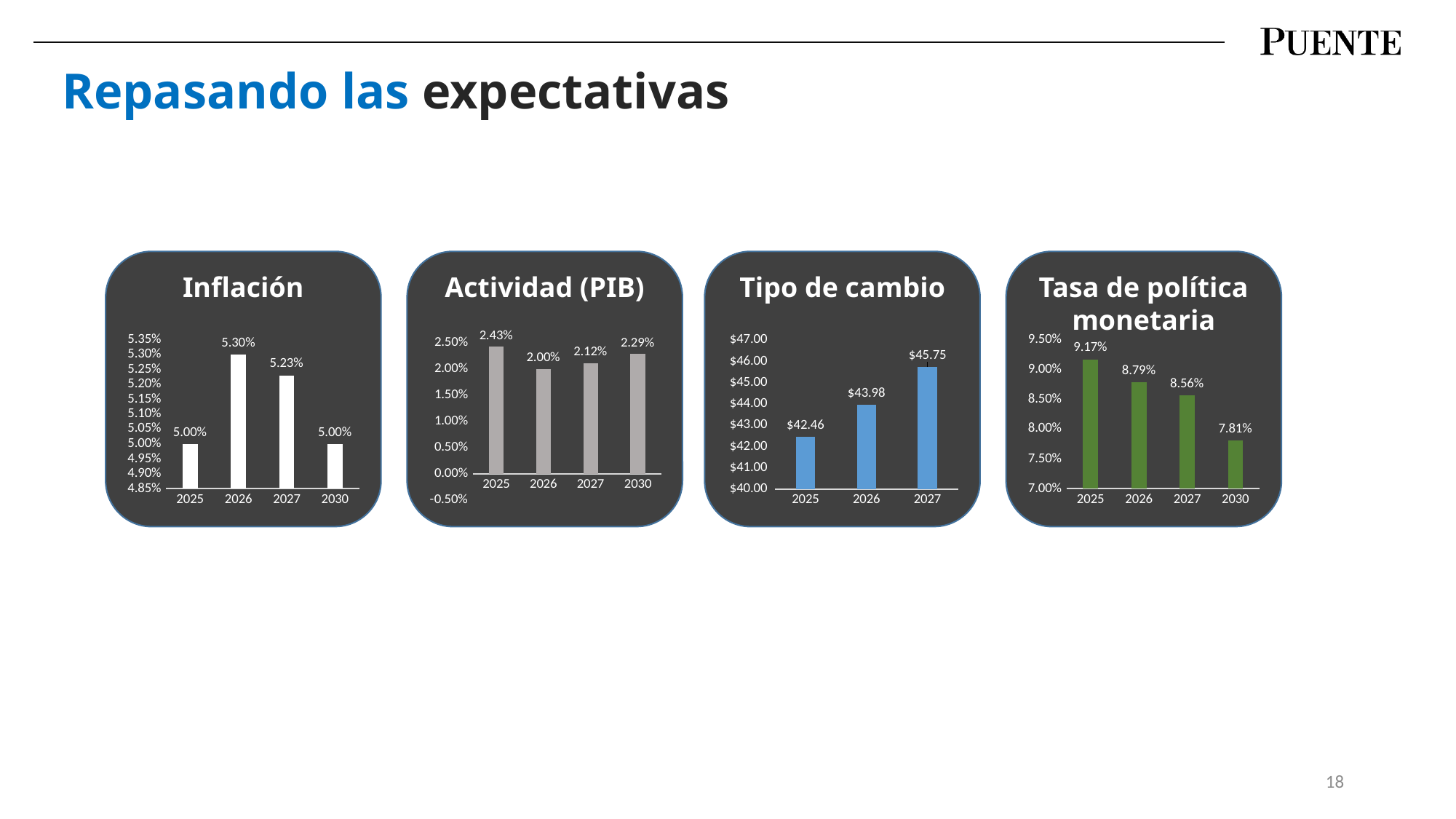
In the Tasa de política monetaria chart, which is larger, the value for 2026 or the value for 2027? 2026 In the Tipo de cambio chart, do the values rise or fall from 2025 to 2027? rise In the Tipo de cambio chart, how many years are shown on the x axis? 3 In the Tasa de política monetaria chart, what is the value for 2030? 7.81% In the Actividad (PIB) chart, which year has the lowest value? 2026 In the Tasa de política monetaria chart, do the values rise or fall from 2025 to 2030? fall In the Tipo de cambio chart, what is the value for 2027? $45.75 In the Inflación chart, what is the value for 2026? 5.30% In the Inflación chart, which year has the highest value? 2026 What kind of chart is the Inflación chart? bar chart In the Actividad (PIB) chart, what is the difference between the values for 2025 and 2026? 0.43% In the Actividad (PIB) chart, what is the value for 2030? 2.29%